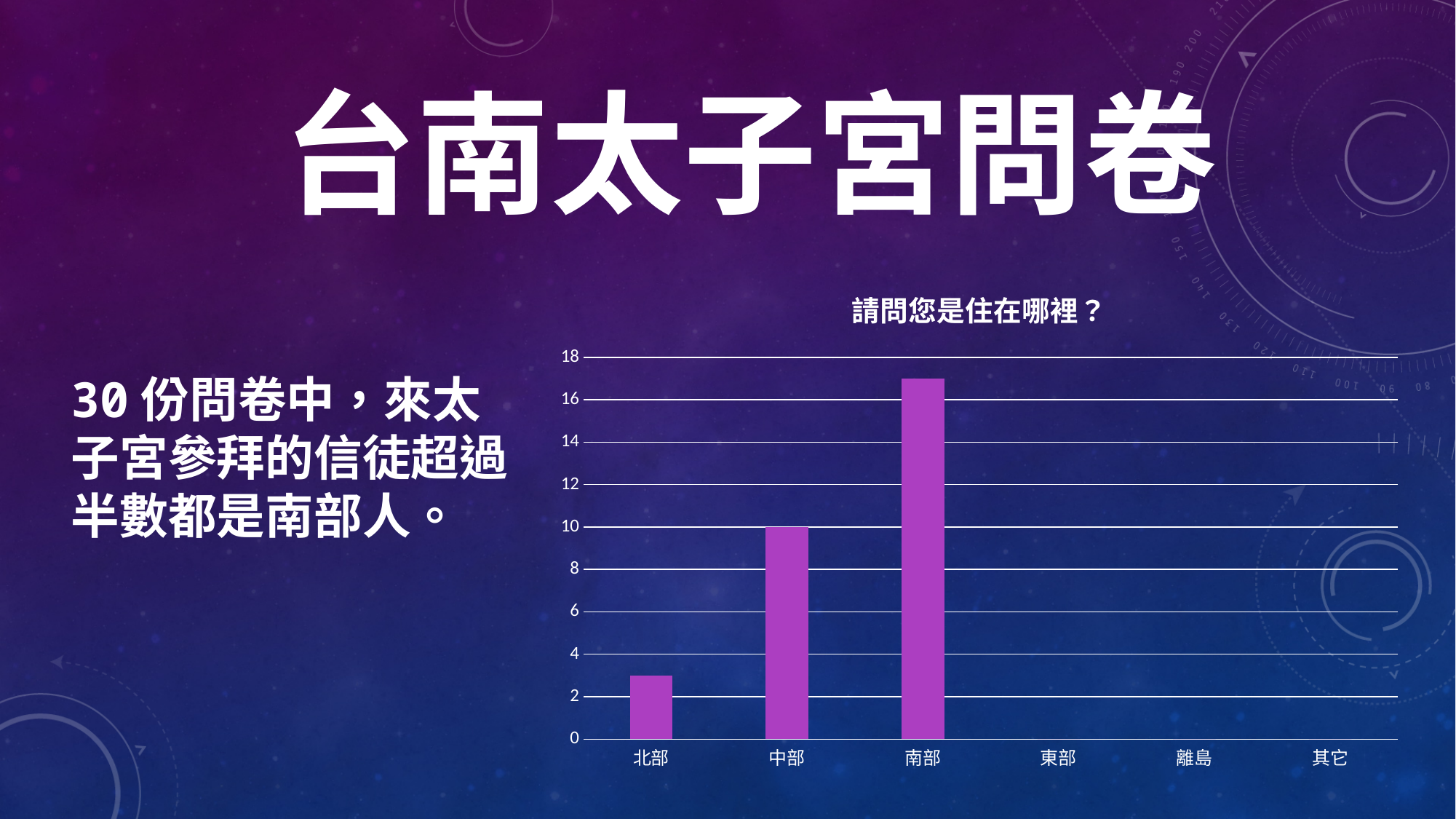
How many categories are shown on the x axis of the chart? 6 Is the value for 南部 greater or less than 16? greater What is the value for 中部 in the chart? 10 Is the value for 南部 greater or less than 18? less What is the title of the chart? 請問您是住在哪裡？ Which category has the highest bar in the chart? 南部 What kind of chart is shown on the slide? bar chart Which is larger, the value for 南部 or the value for 中部? 南部 Which is larger, the value for 中部 or the value for 北部? 中部 What colour are the bars in the chart? purple How many categories in the chart have a visible bar? 3 Is the value for 北部 greater or less than 4? less